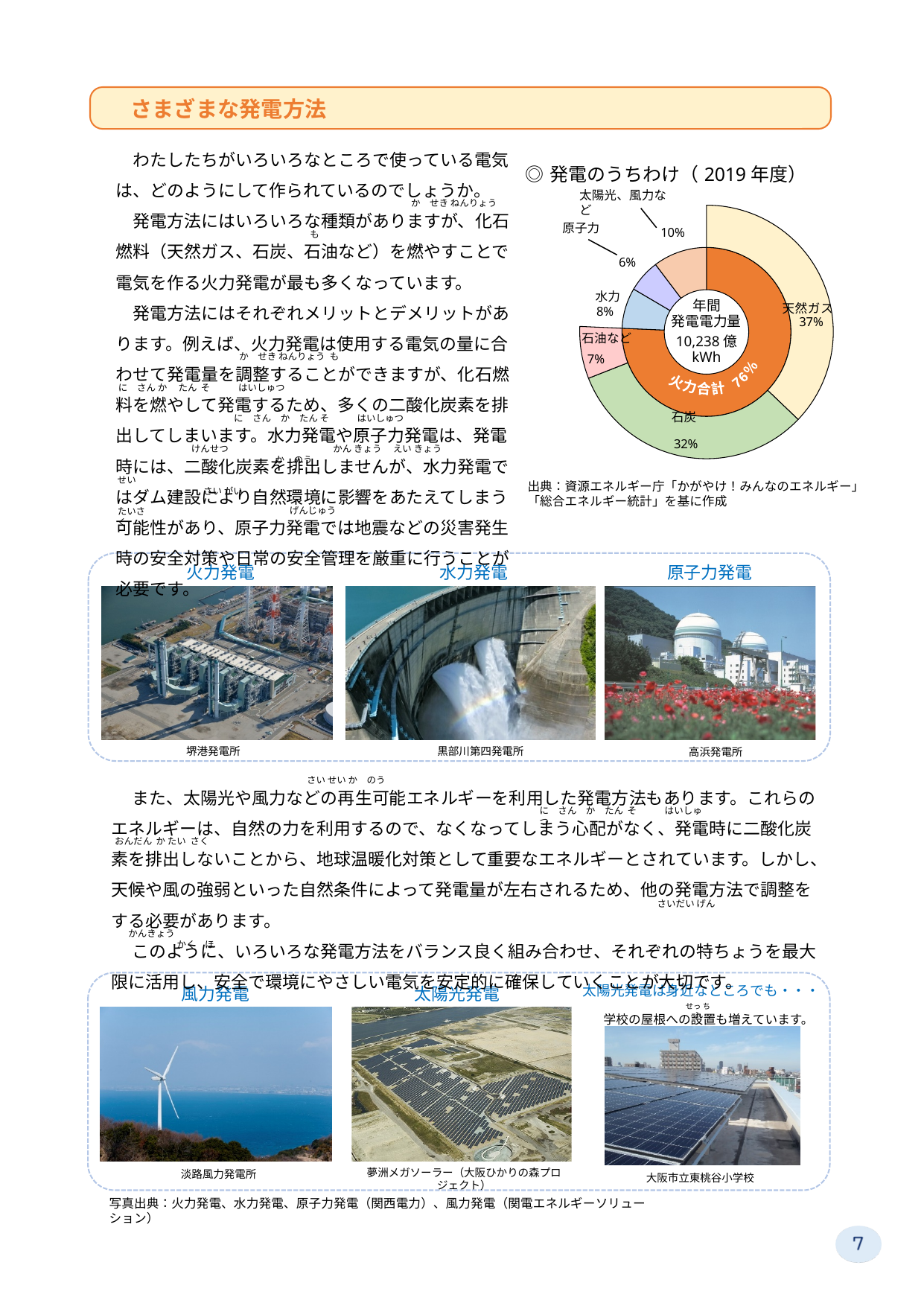
What kind of chart is used to show 発電のうちわけ（2019年度）? Pie (donut) chart In the 発電のうちわけ chart, which category has the smallest share? 原子力 In the 発電のうちわけ chart, what share does 太陽光、風力など have? 10% In the 発電のうちわけ chart, which category has the largest share? 天然ガス In the 発電のうちわけ chart, what share does 水力 have? 8% In the 発電のうちわけ chart, what is the difference between the shares of 天然ガス and 石炭? 5% What annual generation amount (年間発電電力量) is shown in the centre of the 発電のうちわけ chart? 10,238億kWh In the 発電のうちわけ chart, what share does 石炭 have? 32% In the 発電のうちわけ chart, what share does 原子力 have? 6% In the 発電のうちわけ chart, which is larger, the share of 水力 or the share of 石油など? 水力 In the 発電のうちわけ chart, what is the combined share labelled 火力合計? 76% In the 発電のうちわけ chart, what share does 天然ガス have? 37%